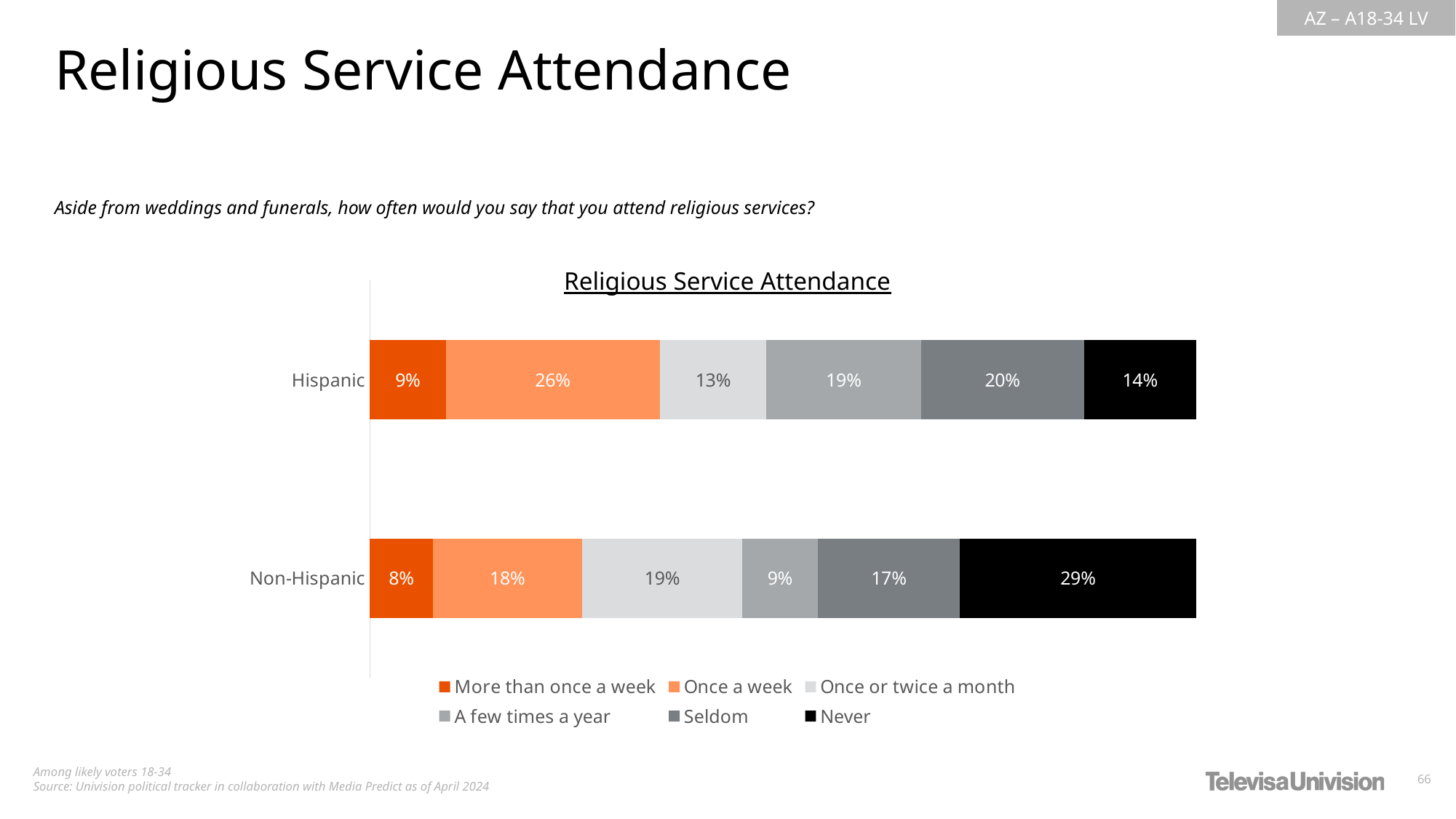
Which response category has the lowest share among Hispanic respondents? More than once a week What percentage of Non-Hispanic respondents say they never attend religious services? 29% Which response category has the highest share among Hispanic respondents? Once a week How many series does the legend list? 6 How many groups are shown on the chart? 2 What is the difference between the Non-Hispanic and Hispanic shares for 'Never'? 15 percentage points What percentage of Hispanic respondents attend religious services once a week? 26% What kind of chart is shown on the slide? Stacked bar chart Which response category has the highest share among Non-Hispanic respondents? Never What percentage of Non-Hispanic respondents attend religious services a few times a year? 9% What percentage of Hispanic respondents attend religious services more than once a week? 9% Which group has a larger share attending once a week, Hispanic or Non-Hispanic? Hispanic